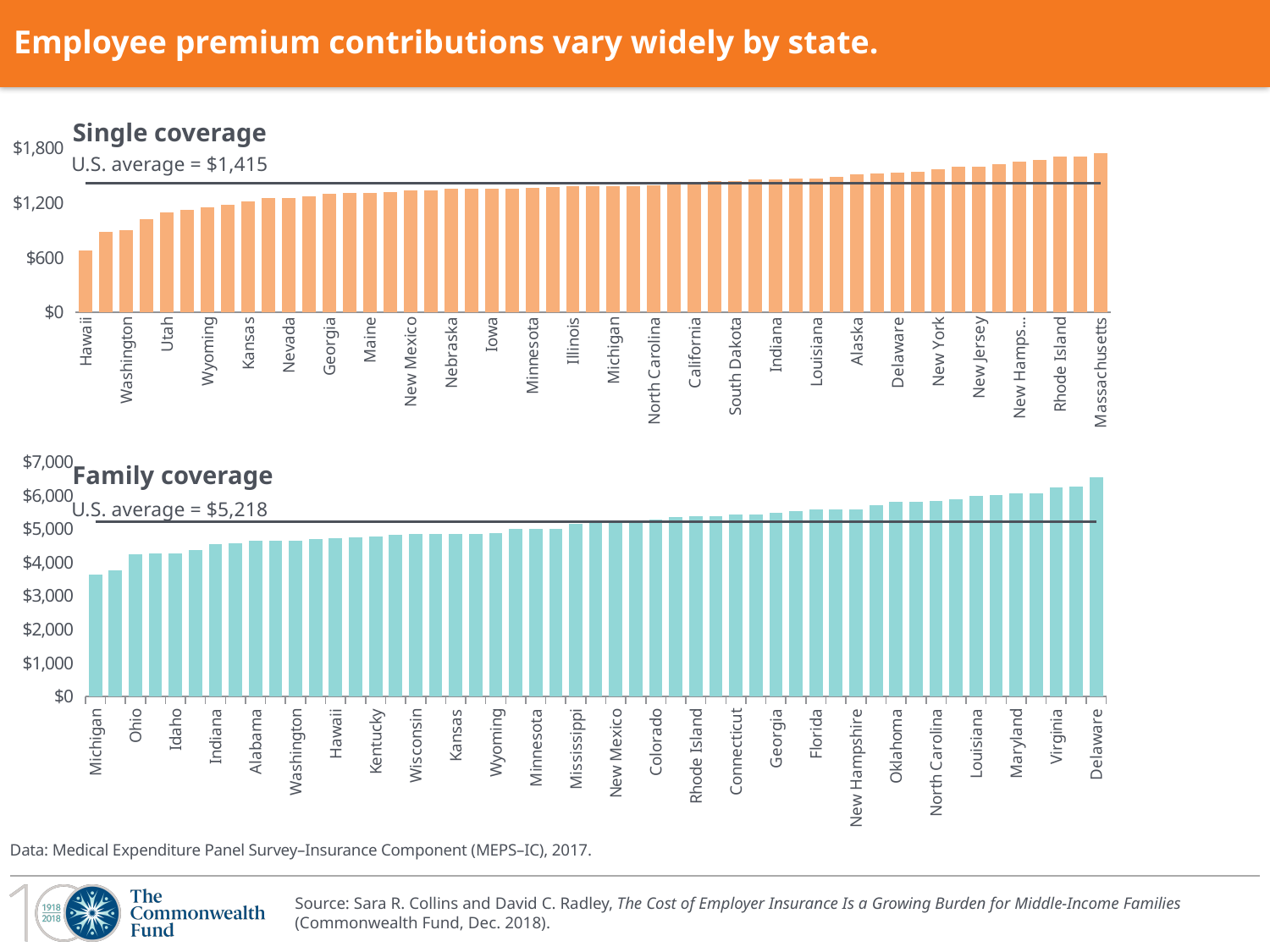
What is the U.S. average shown on the Family coverage chart? $5,218 In the Single coverage chart, which state has the lowest employee premium contribution? Hawaii In the Single coverage chart, is the value for Hawaii greater or less than $1,200? less In the Family coverage chart, which state has the larger value, Michigan or Delaware? Delaware In the Single coverage chart, do the bar values rise or fall from left to right? Rise In the Family coverage chart, which state has the lowest employee premium contribution? Michigan What kind of chart is the Single coverage chart? Bar chart In the Single coverage chart, is the value for Massachusetts greater or less than $1,200? greater In the Family coverage chart, is the value for Delaware greater or less than $6,000? greater In the Single coverage chart, which state has the highest employee premium contribution? Massachusetts In the Family coverage chart, which state has the highest employee premium contribution? Delaware